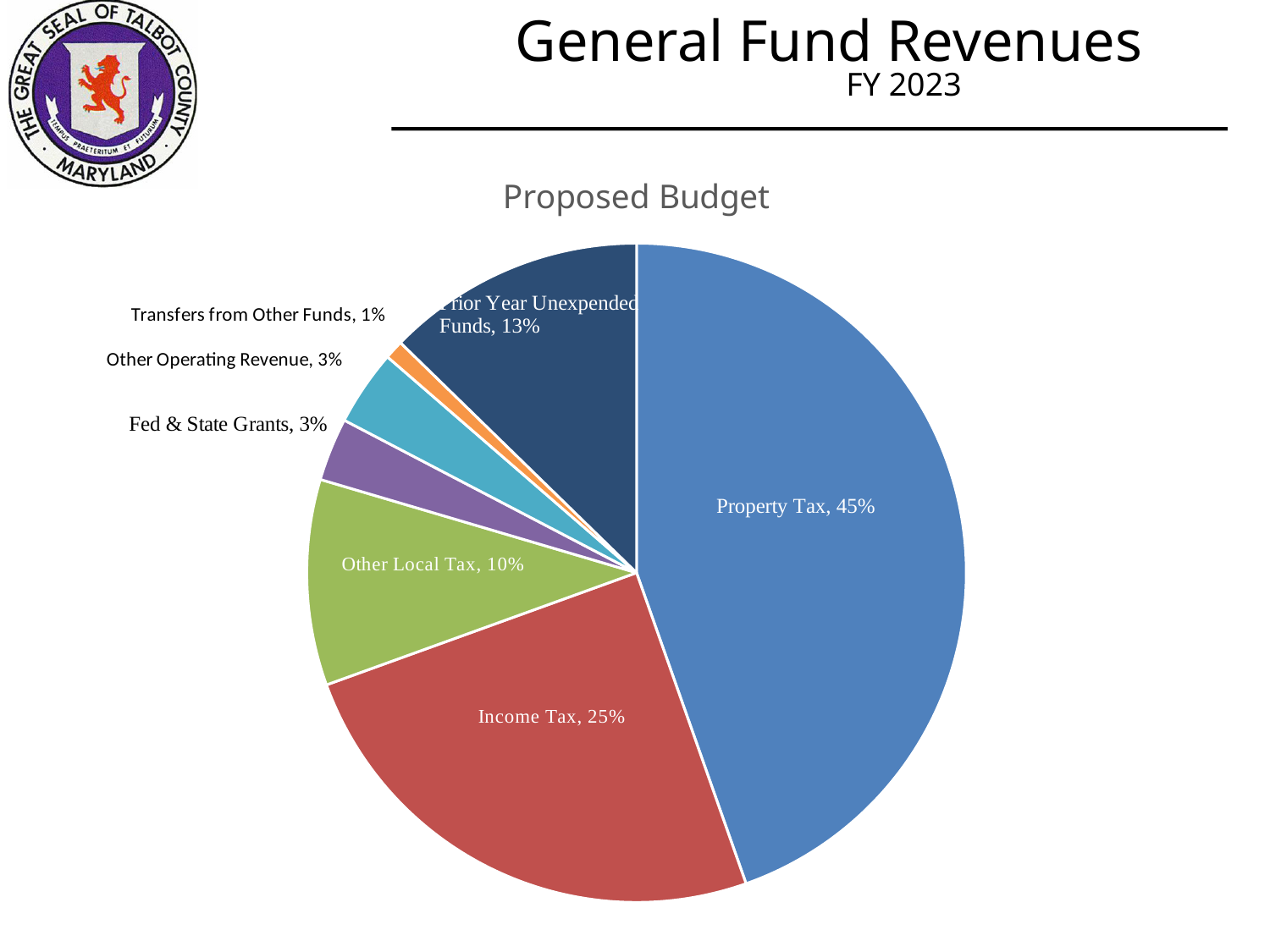
What is the title shown directly above the chart? Proposed Budget What share of the pie does Property Tax represent? 45% What percentage is shown for Other Local Tax? 10% How many slices does the pie chart have? 7 What type of chart is shown on the slide? Pie chart What percentage is shown for Income Tax? 25% Which category has the largest slice of the pie? Property Tax Which category has the smallest slice of the pie? Transfers from Other Funds What is the value labelled for Prior Year Unexpended Funds? 13% Which is larger, Prior Year Unexpended Funds or Other Local Tax? Prior Year Unexpended Funds What share is shown for Transfers from Other Funds? 1% What is the difference in percentage points between Property Tax and Income Tax? 20